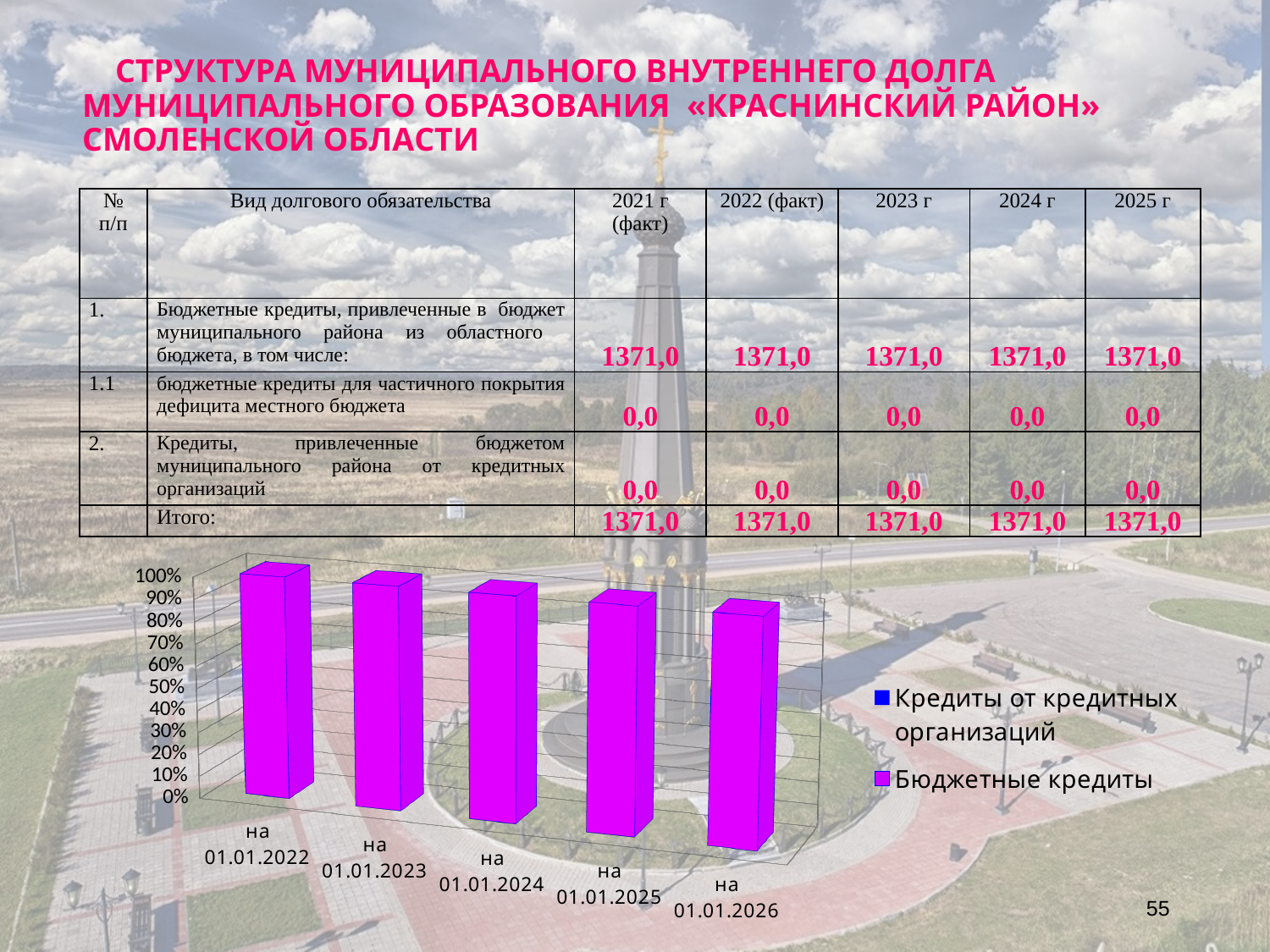
How many categories are shown on the x axis of the chart? 5 What is the first category label on the x axis of the chart? на 01.01.2022 What is the highest tick shown on the chart's vertical axis? 100% Which series is shown in magenta in the chart? Бюджетные кредиты What kind of chart is shown on the slide? bar chart How many series does the chart legend list? 2 Is the value for Бюджетные кредиты at на 01.01.2026 greater or less than 50%? greater Do the bars for Бюджетные кредиты rise, fall, or stay the same across the x axis from на 01.01.2022 to на 01.01.2026? stay the same Is the value for Кредиты от кредитных организаций at на 01.01.2024 greater or less than 50%? less Is the value for Бюджетные кредиты at на 01.01.2022 greater or less than 50%? greater